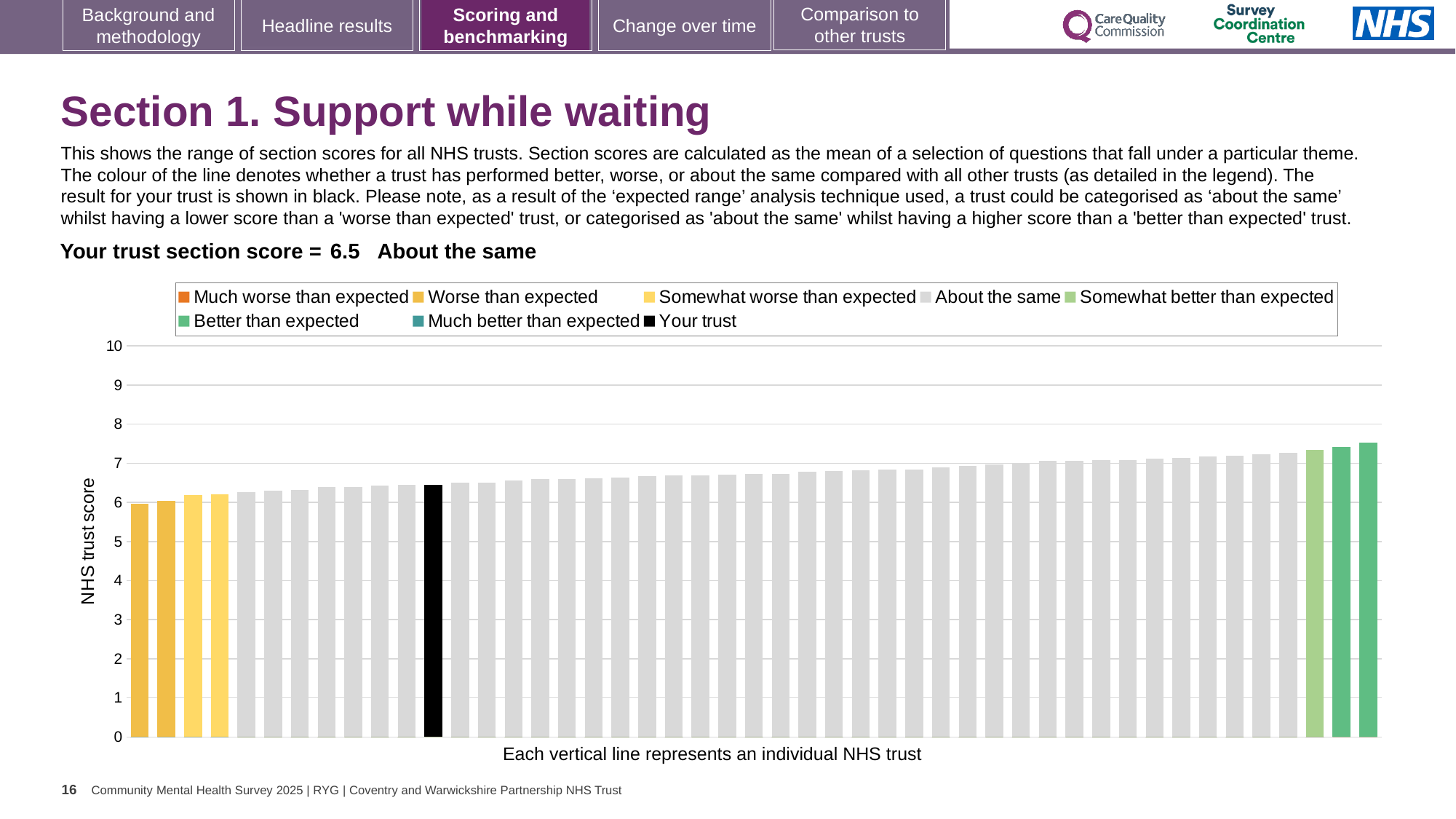
Is the value of the tallest bar greater or less than 8? less How many bars are coloured green for 'Better than expected'? 2 Do the bar values rise or fall from left to right along the x axis? rise What kind of chart is shown on the slide? bar chart Is the value of the black bar (your trust) greater or less than 7? less What is the section score for your trust shown on the slide? 6.5 According to the caption under the chart, what does each vertical line represent? an individual NHS trust How many entries does the chart legend list? 8 Which category is your trust's section score placed in? About the same Is the value of the shortest bar greater or less than 5? greater What is the label on the vertical axis of the chart? NHS trust score Which bar is taller, the leftmost bar or the rightmost bar? the rightmost bar